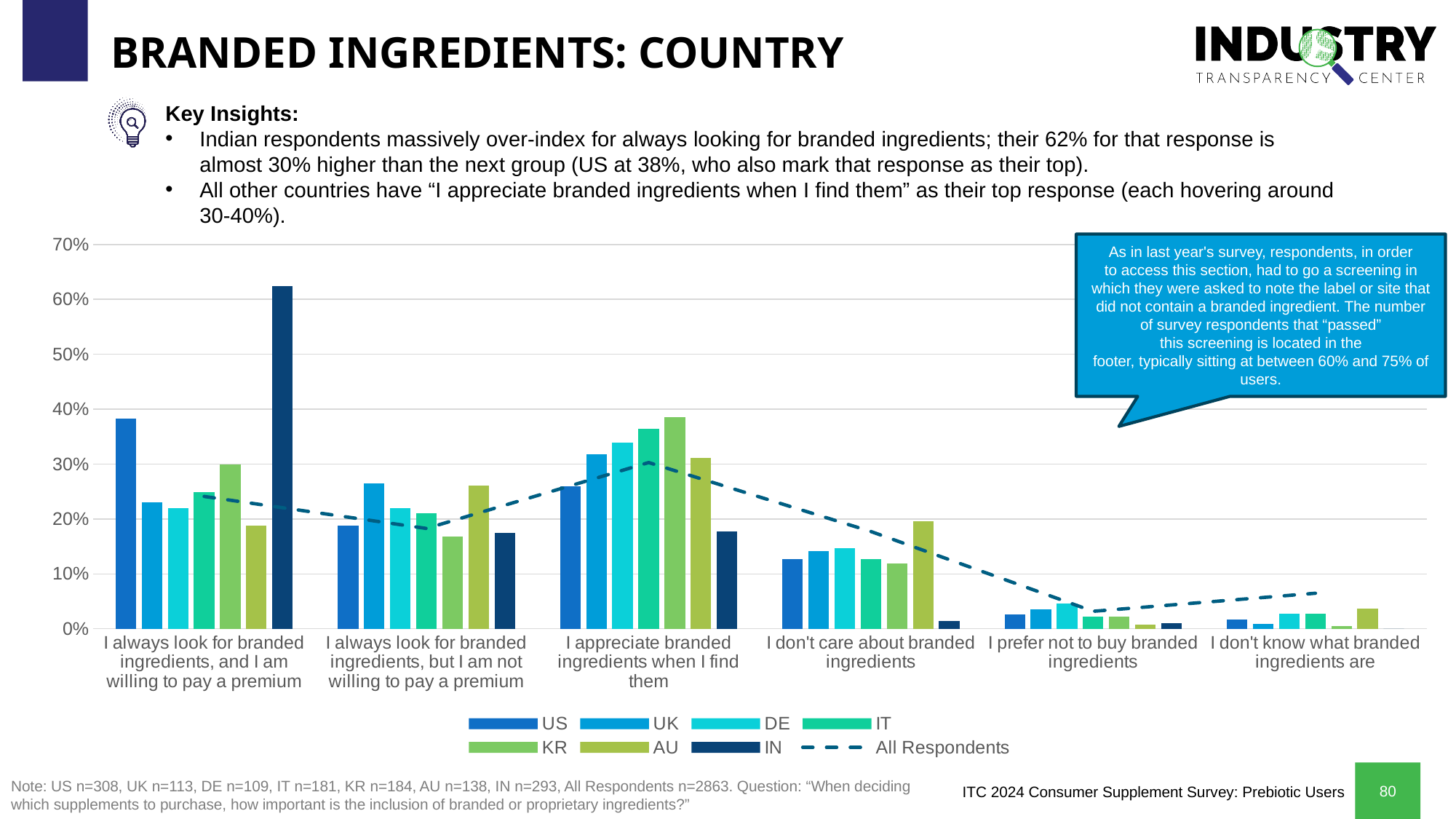
What does the dashed line in the chart represent? All Respondents What kind of chart is shown on the slide? combination bar and line chart For "I don't care about branded ingredients", which is larger, the AU value or the IN value? AU Is the AU value for "I don't care about branded ingredients" greater or less than 10%? greater Which country has the highest bar for "I appreciate branded ingredients when I find them"? KR Is the IN value for "I always look for branded ingredients, and I am willing to pay a premium" greater or less than 60%? greater How many series does the legend list? 8 Is the US value for "I always look for branded ingredients, and I am willing to pay a premium" greater or less than 30%? greater For "I always look for branded ingredients, but I am not willing to pay a premium", which is larger, the UK value or the KR value? UK Which country has the highest bar for "I always look for branded ingredients, and I am willing to pay a premium"? IN Which country has the lowest bar for "I appreciate branded ingredients when I find them"? IN How many response categories are shown along the x axis? 6